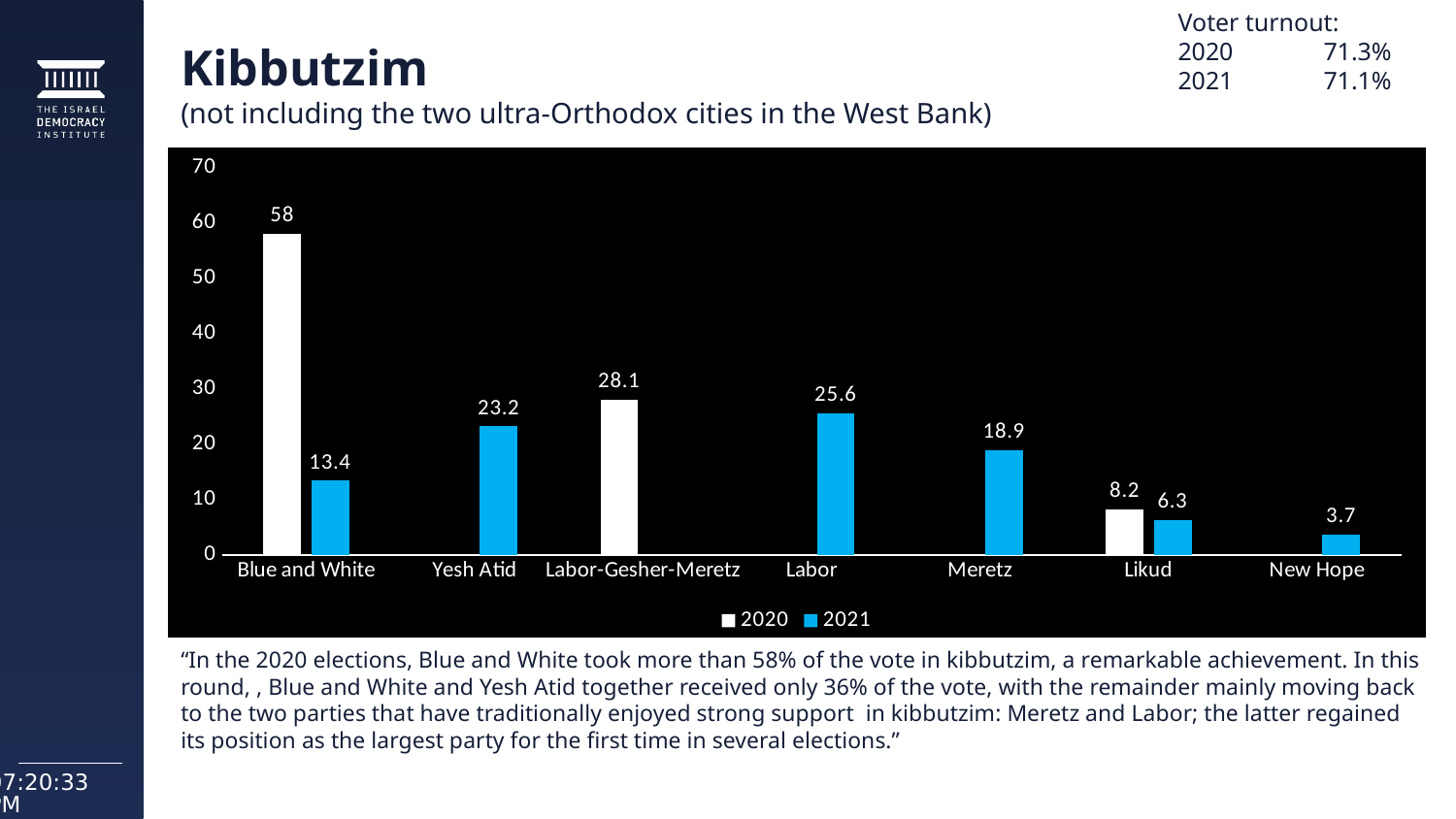
Which is larger, the 2021 value for Labor or the 2021 value for Yesh Atid? Labor What is the 2021 value for Yesh Atid? 23.2 Which category has the highest 2021 value? Labor What is the 2020 value for Labor-Gesher-Meretz? 28.1 What is the 2021 value for Blue and White? 13.4 How many categories are shown on the x axis? 7 Which category has the lowest 2021 value? New Hope What is the difference between the 2020 and 2021 values for Blue and White? 44.6 What is the 2020 value for Blue and White? 58 What is the 2021 value for Meretz? 18.9 How many series does the legend list? 2 What kind of chart is shown on the slide? bar chart